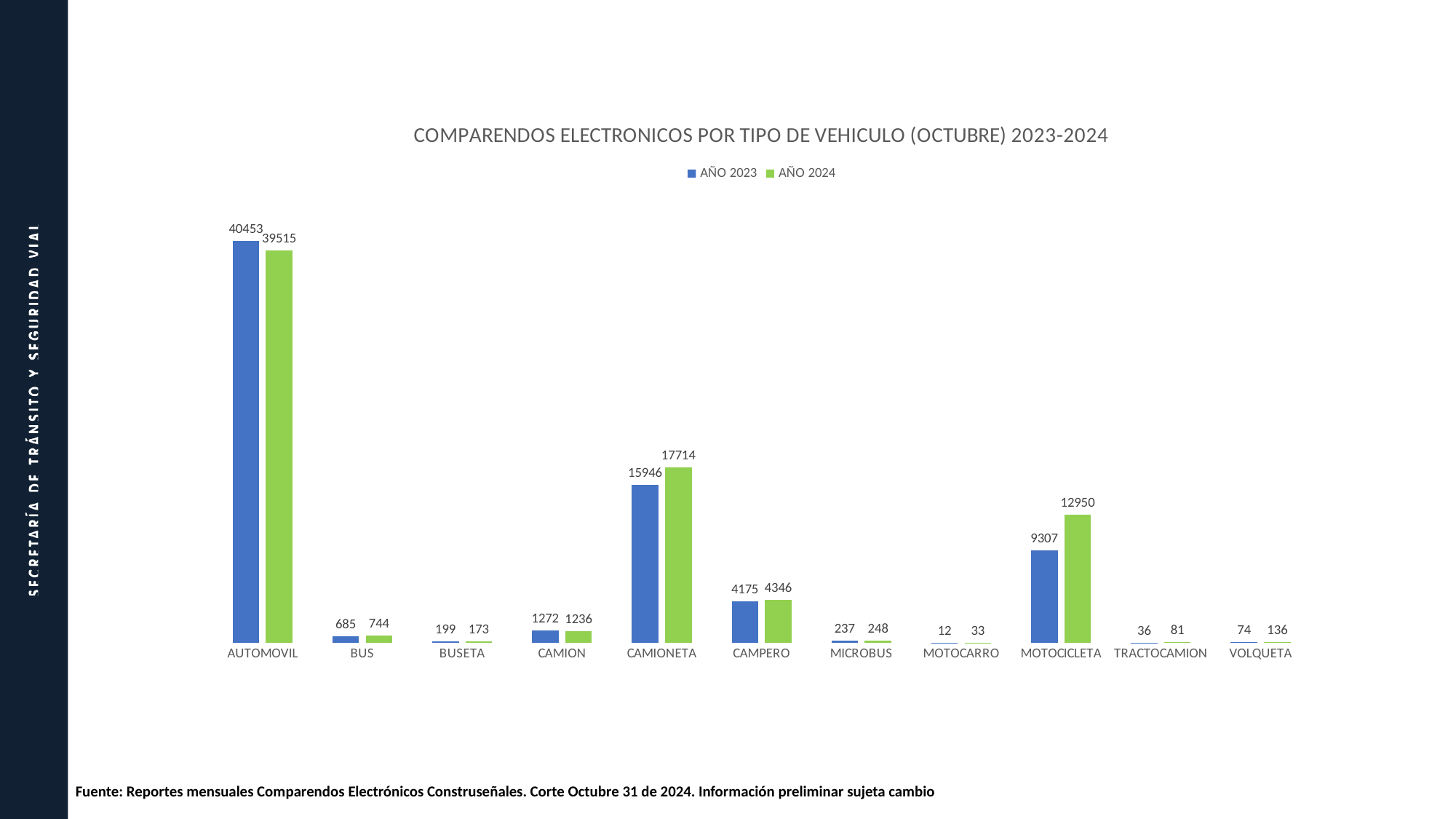
What is the value for MOTOCICLETA in the AÑO 2024 series? 12950 What is the value for CAMIONETA in the AÑO 2024 series? 17714 What type of chart is shown on the slide? Bar chart Which vehicle type has the highest value in the AÑO 2023 series? AUTOMOVIL How many series does the legend list? 2 What is the difference between the AÑO 2024 and AÑO 2023 values for MOTOCICLETA? 3643 What is the difference between the AÑO 2023 and AÑO 2024 values for AUTOMOVIL? 938 For VOLQUETA, which series has the larger value, AÑO 2023 or AÑO 2024? AÑO 2024 Which vehicle type has the lowest value in the AÑO 2024 series? MOTOCARRO For CAMION, which series has the larger value, AÑO 2023 or AÑO 2024? AÑO 2023 What is the value for AUTOMOVIL in the AÑO 2023 series? 40453 How many vehicle types are shown on the x axis? 11